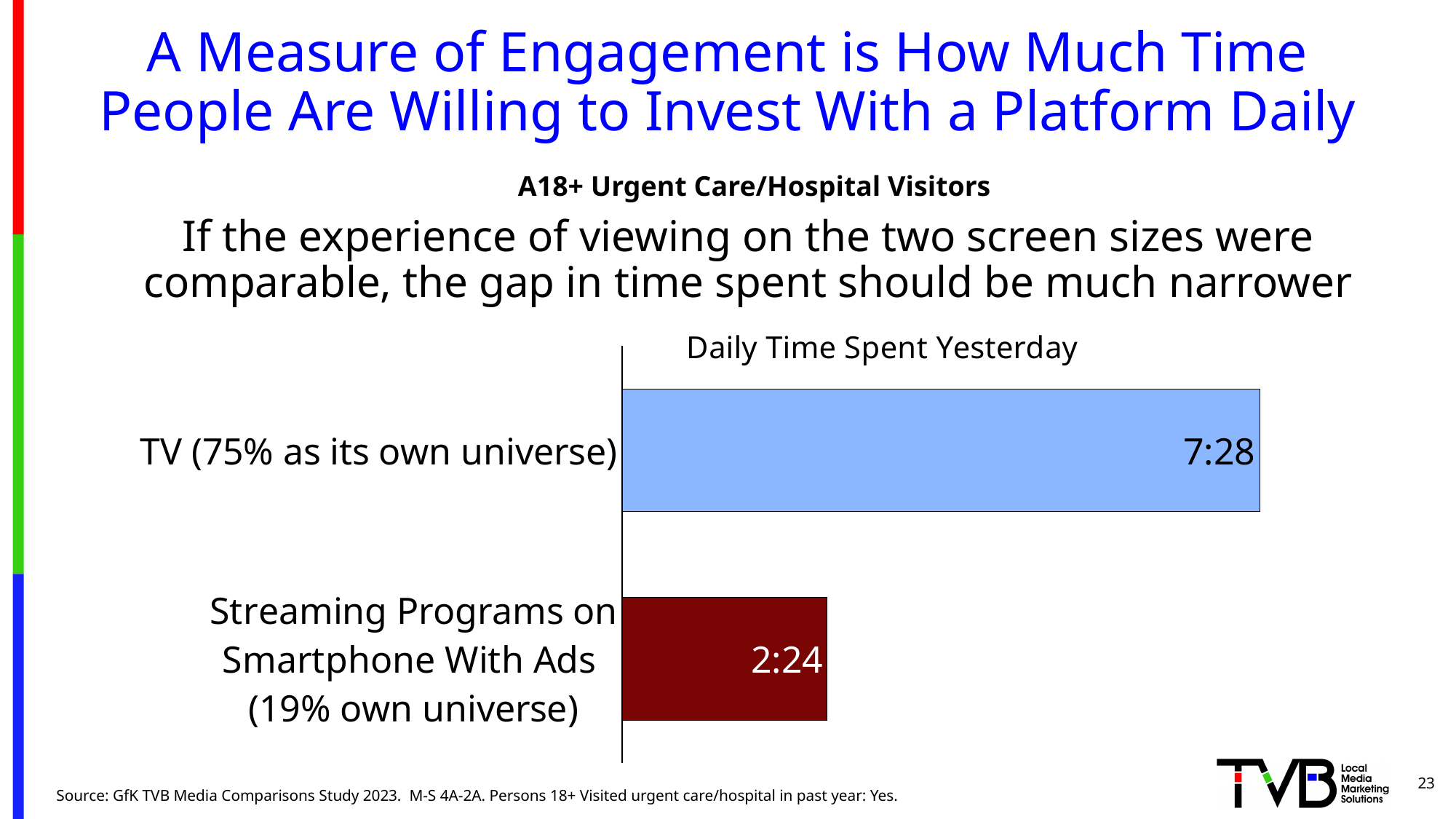
What kind of chart is shown on the slide? Bar chart What colour is the bar for TV (75% as its own universe)? Light blue What is the difference in daily time spent between TV (7:28) and Streaming Programs on Smartphone With Ads (2:24)? 5:04 What is the title of the chart? Daily Time Spent Yesterday What is the daily time spent yesterday for Streaming Programs on Smartphone With Ads (19% own universe)? 2:24 Which is larger: daily time spent on TV or on Streaming Programs on Smartphone With Ads? TV How many categories are shown in the chart? 2 Which category has the highest daily time spent yesterday? TV (75% as its own universe) What is the daily time spent yesterday for TV (75% as its own universe)? 7:28 Which category has the lowest daily time spent yesterday? Streaming Programs on Smartphone With Ads (19% own universe)